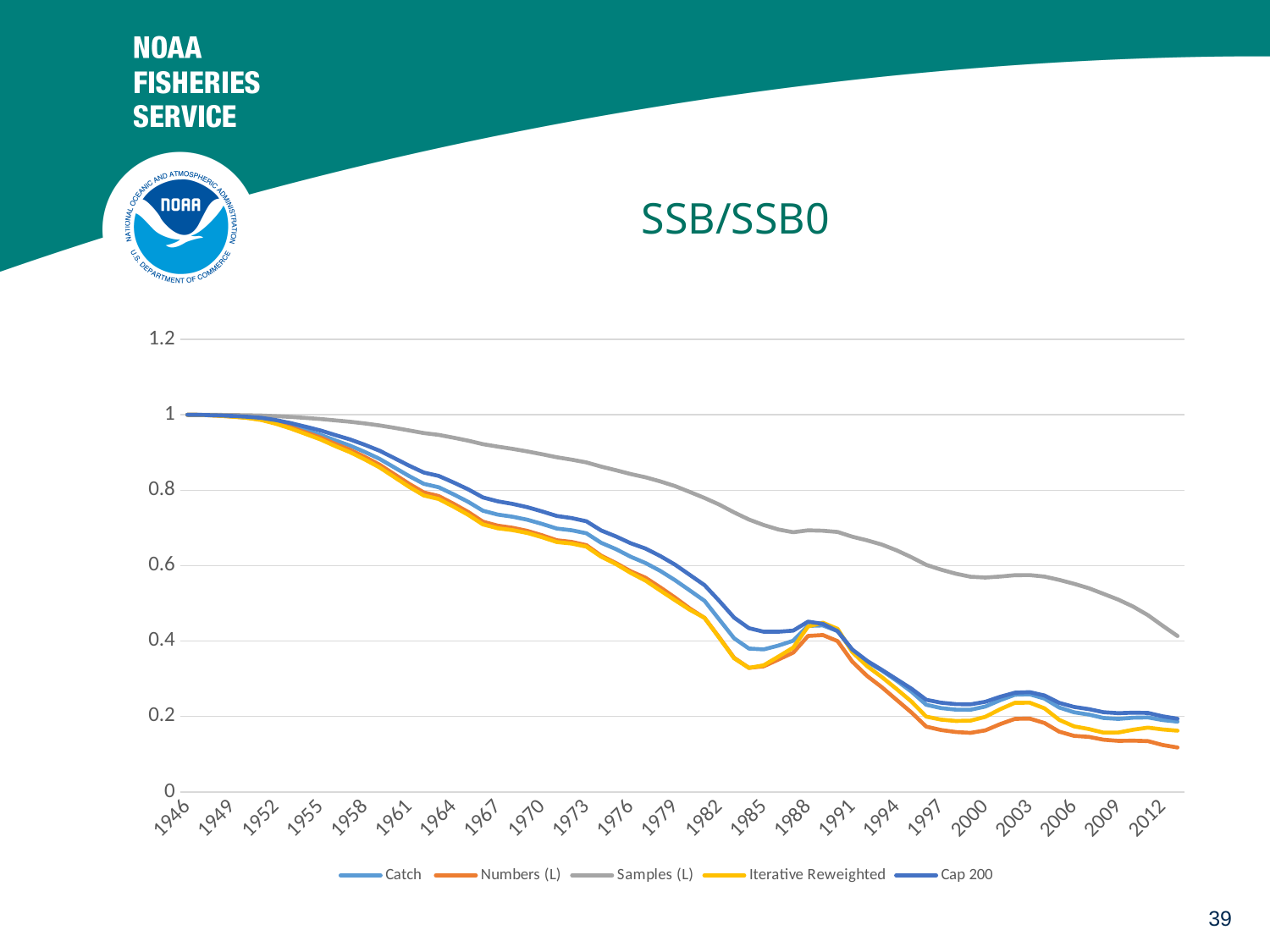
Is the value for Cap 200 in 1973 greater or less than 0.6? greater What kind of chart is shown on the slide? line chart How many series does the legend list? 5 Which series is drawn in grey? Samples (L) Which series has the lowest value in 2012? Numbers (L) Is the value for Samples (L) in 2000 greater or less than 0.6? less Is the value for Numbers (L) in 2012 greater or less than 0.2? less What is the value of the series in 1946, where all the lines start? 1 Which series has the highest value in 2012? Samples (L) What is the title of the chart? SSB/SSB0 Do the values generally rise or fall from 1946 to 2012? fall In 2000, which is larger, the value for Samples (L) or the value for Catch? Samples (L)